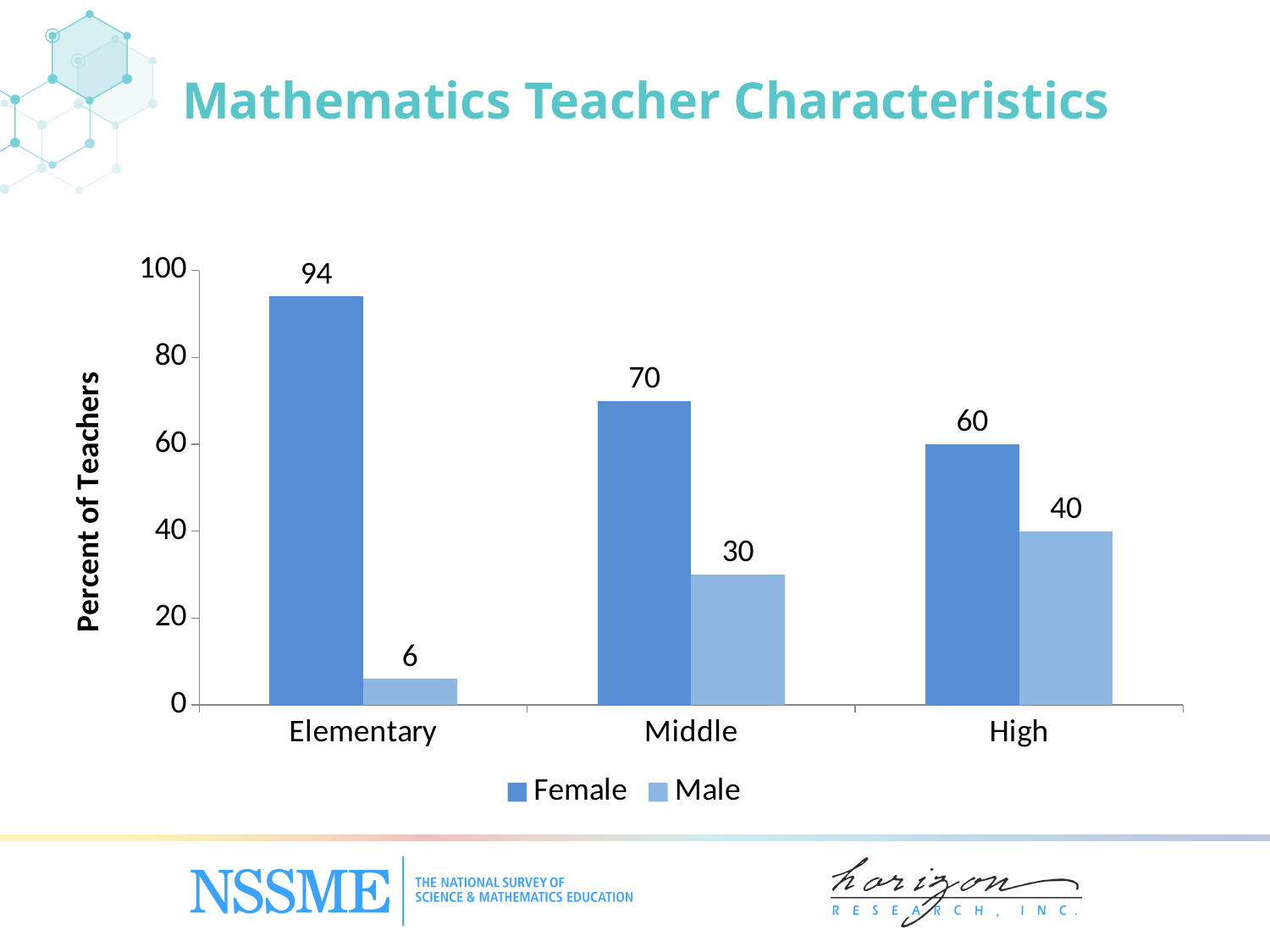
How many series does the legend list? 2 What is the label of the y axis? Percent of Teachers Which category has the lowest Male value? Elementary Which category has the highest Female value? Elementary What is the value for Female at Elementary? 94 Is the Male value at Middle greater or less than 40? less Which is larger, the Female value at Middle or the Female value at High? Female value at Middle How many categories are shown on the x axis? 3 What is the value for Male at High? 40 What is the value for Male at Middle? 30 What kind of chart is shown on the slide? bar chart What is the difference between the Female and Male values at High? 20